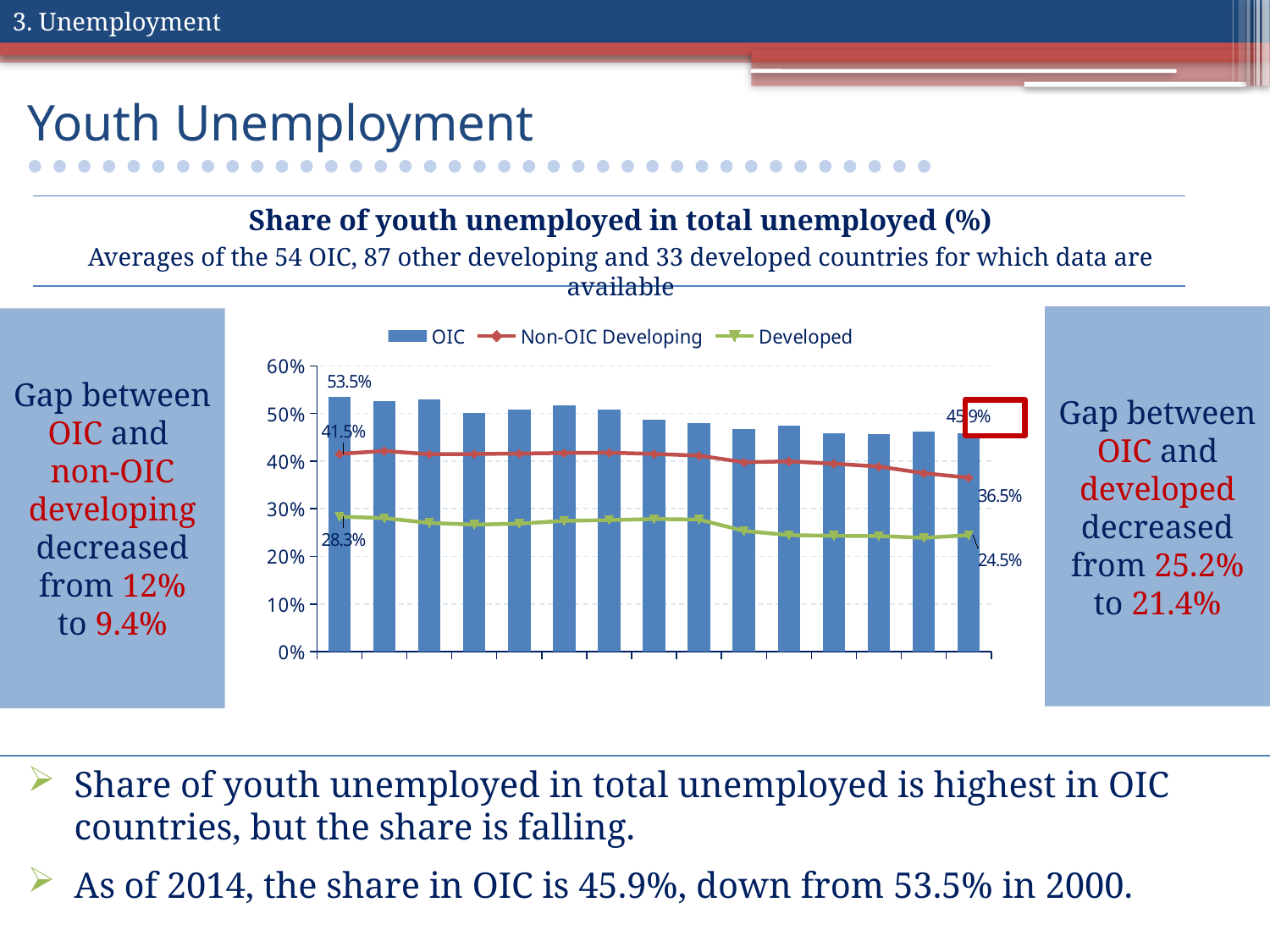
Is the last value of the Developed series greater or less than 30%? less By how many percentage points did the OIC value fall from its first labelled value (53.5%) to its last labelled value (45.9%)? 7.6 What is the first labelled value of the Non-OIC Developing series? 41.5% Which series has the highest values throughout the chart? OIC Which series has the lowest values throughout the chart? Developed How many series does the chart legend list? 3 What is the data label on the last OIC bar in the chart? 45.9% What is the last labelled value of the Non-OIC Developing series? 36.5% What is the first labelled value of the Developed series? 28.3% What is the data label on the first OIC bar in the chart? 53.5% Does the OIC series rise or fall along the x axis? fall What is the last labelled value of the Developed series? 24.5%